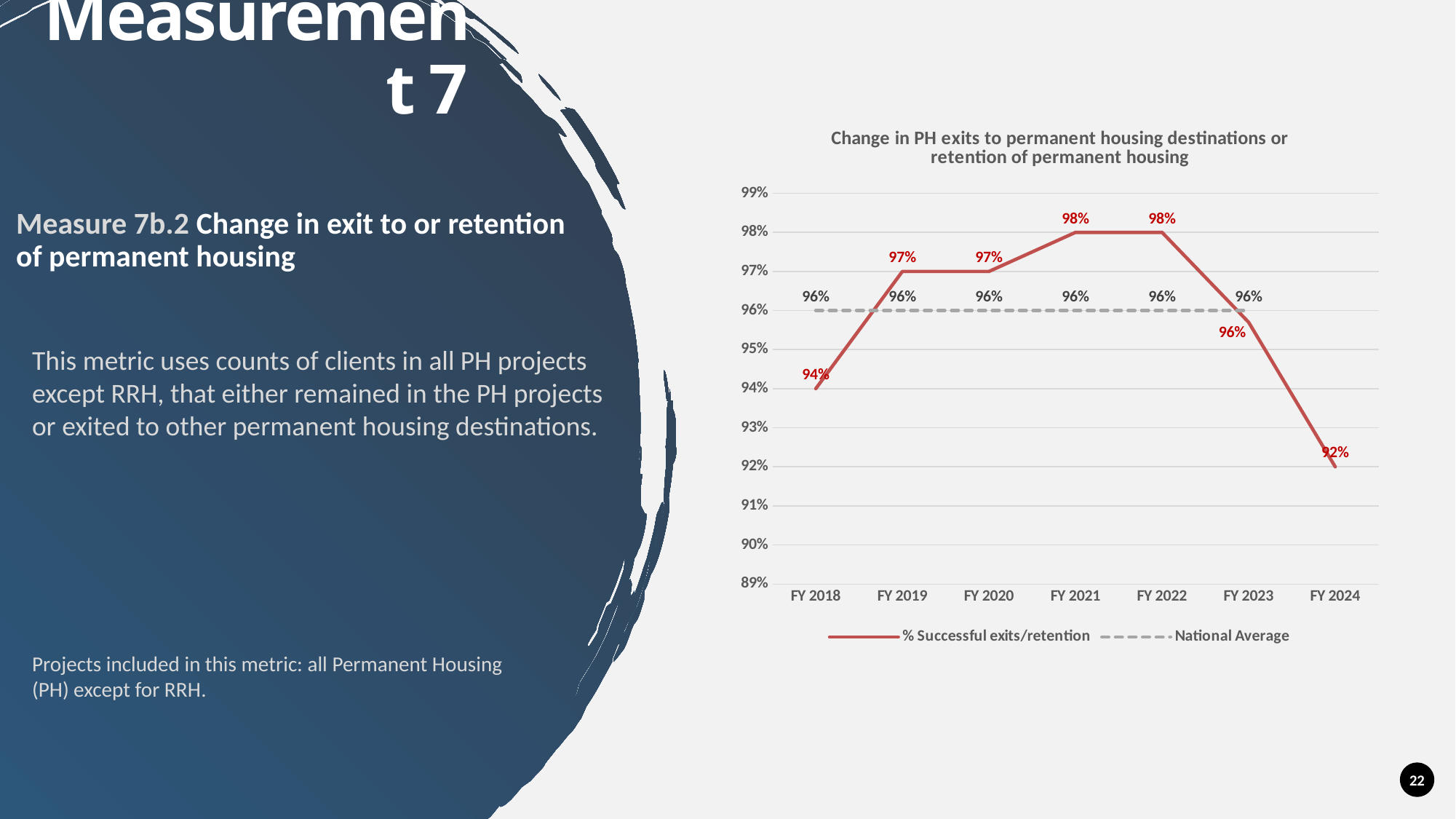
What is the difference between the % Successful exits/retention values for FY 2021 and FY 2024? 6 percentage points What is the title of the chart? Change in PH exits to permanent housing destinations or retention of permanent housing Which series in the chart is drawn with a dashed line? National Average How many series does the chart legend list? 2 In which fiscal year is the % Successful exits/retention value lowest? FY 2024 Which is larger, the % Successful exits/retention value for FY 2019 or for FY 2024? FY 2019 What is the % Successful exits/retention value for FY 2024? 92% What type of chart is shown on the slide? Line chart What is the % Successful exits/retention value for FY 2018? 94% What is the National Average value shown for FY 2020? 96% How many fiscal years are shown on the x axis of the chart? 7 Does the % Successful exits/retention line rise or fall from FY 2022 to FY 2024? Fall